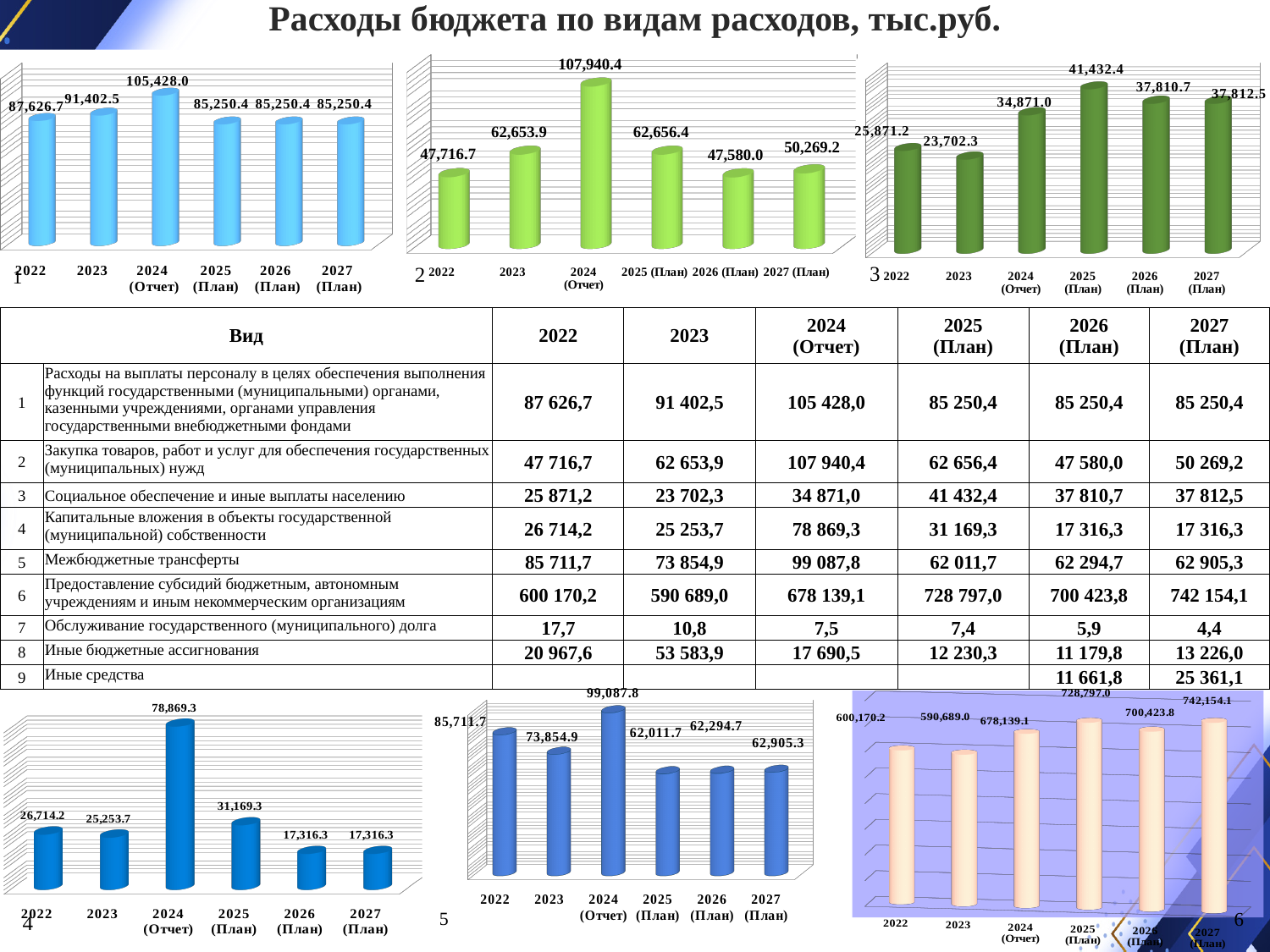
How many categories (years) are shown in the top-left chart (chart 1)? 6 In the top-middle chart (chart 2), what is the difference between the 2024 (Отчет) value and the 2023 value? 45,286.5 In the top-left chart (chart 1), do the values rise or fall from 2022 to 2024 (Отчет)? Rise In the bottom-right chart (chart 6), what is the value for 2027 (План)? 742,154.1 In the top-middle chart (chart 2), what is the value for 2026 (План)? 47,580.0 In the bottom-right chart (chart 6), which is larger: the value for 2025 (План) or the value for 2026 (План)? 2025 (План) In the bottom-middle chart (chart 5), which is larger: the value for 2022 or the value for 2023? 2022 In the top-right chart (chart 3), which year has the highest value? 2025 (План) In the top-left chart (chart 1), what is the value for 2024 (Отчет)? 105,428.0 What kind of chart is the bottom-middle chart (chart 5)? Bar chart In the bottom-left chart (chart 4), what is the difference between the 2024 (Отчет) value and the 2025 (План) value? 47,700.0 In the bottom-left chart (chart 4), which year has the lowest value? 2026 (План) and 2027 (План)